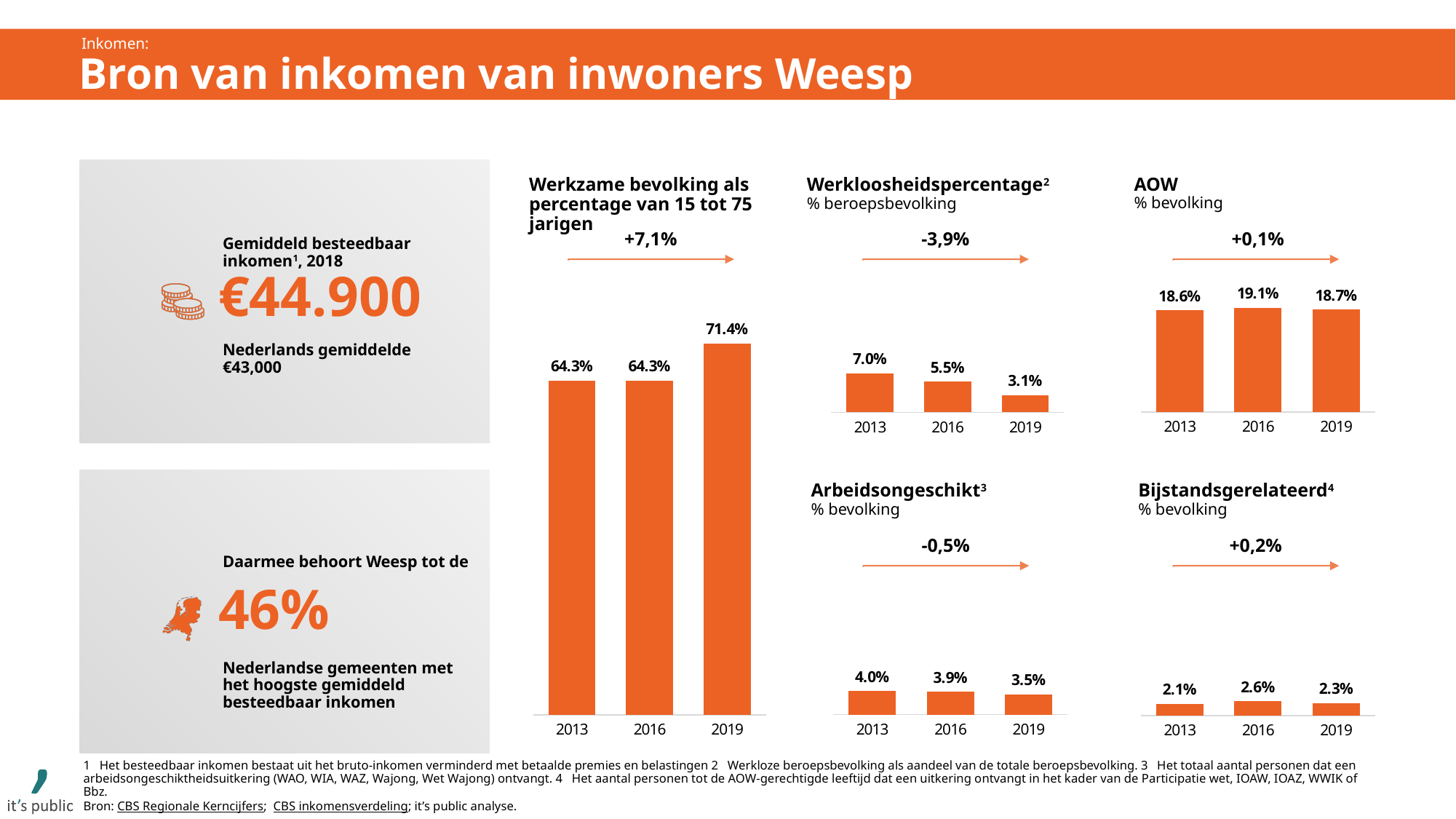
In the 'Werkloosheidspercentage' chart, do the values rise or fall from 2013 to 2019? fall What change is shown by the arrow above the 'Werkzame bevolking als percentage van 15 tot 75 jarigen' chart? +7,1% In the 'Arbeidsongeschikt' chart, what is the value for 2016? 3.9% What kind of chart is the 'AOW' chart? bar chart In the 'Werkzame bevolking als percentage van 15 tot 75 jarigen' chart, what is the value for 2019? 71.4% In the 'Bijstandsgerelateerd' chart, what is the difference between the 2016 and 2013 values? 0.5% How many years are shown on the x axis of the 'Arbeidsongeschikt' chart? 3 In the 'Bijstandsgerelateerd' chart, which is larger: the value for 2016 or the value for 2019? 2016 In the 'Werkloosheidspercentage' chart, what is the difference between the 2013 and 2019 values? 3.9% In the 'Werkloosheidspercentage' chart, which year has the lowest value? 2019 In the 'Werkloosheidspercentage' chart, what is the value for 2013? 7.0% In the 'AOW' chart, which year has the highest value? 2016